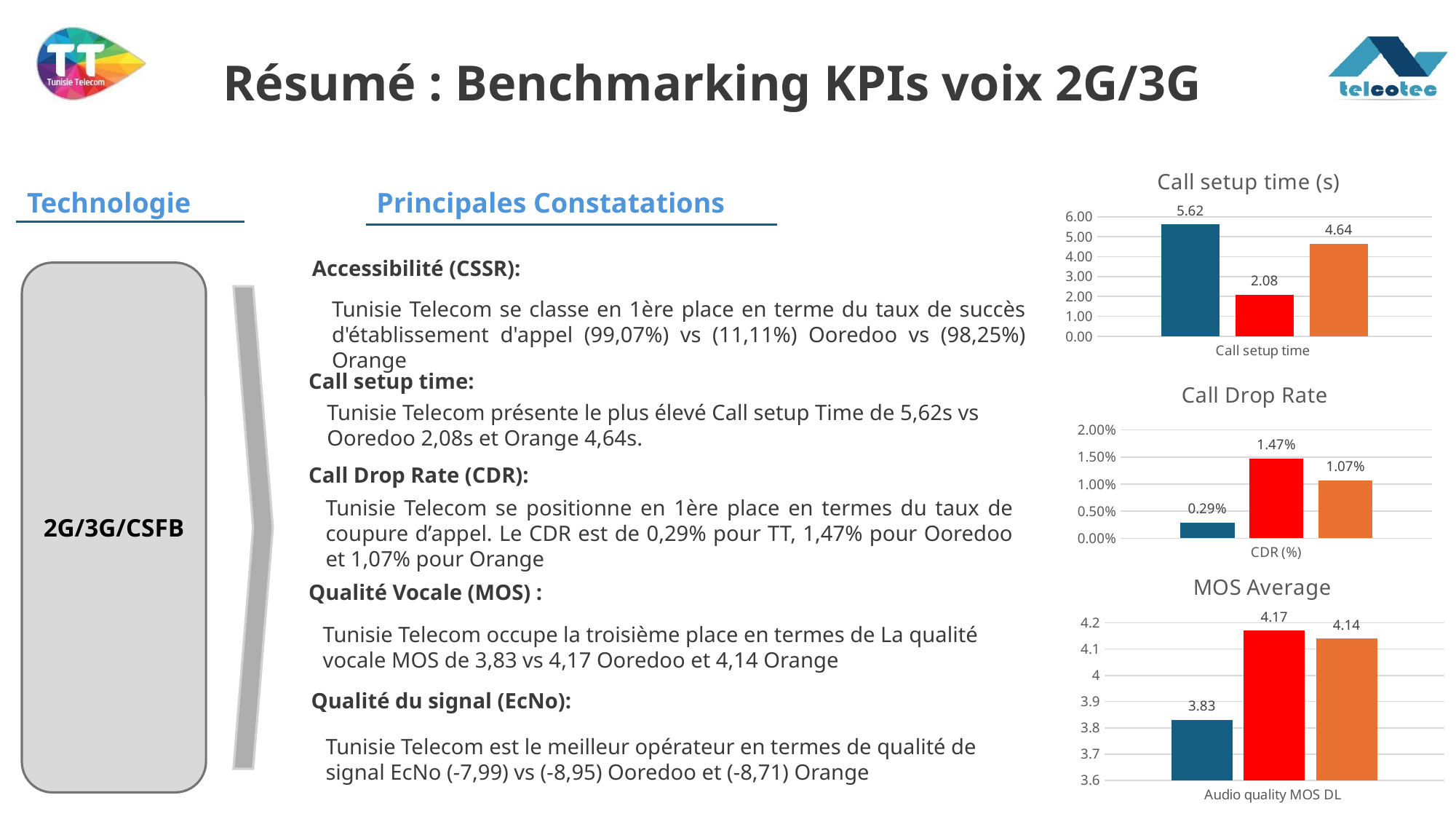
In the 'Call setup time (s)' chart, what is the value of the red bar? 2.08 In the 'MOS Average' chart, what is the value of the orange bar? 4.14 In the 'Call Drop Rate' chart, which bar is the highest? The red bar (1.47%) How many bars are shown in the 'Call Drop Rate' chart? 3 In the 'Call Drop Rate' chart, what is the difference between the red bar and the blue bar? 1.18% In the 'Call setup time (s)' chart, what is the difference between the blue bar and the red bar? 3.54 In the 'MOS Average' chart, is the value of the blue bar greater or less than 4? less In the 'Call setup time (s)' chart, which bar is the lowest? The red bar (2.08) In the 'Call setup time (s)' chart, what is the value of the blue bar? 5.62 In the 'MOS Average' chart, which is larger, the red bar or the blue bar? The red bar (4.17) In the 'Call Drop Rate' chart, what is the value of the blue bar? 0.29% What type of chart is the 'MOS Average' chart? Bar chart